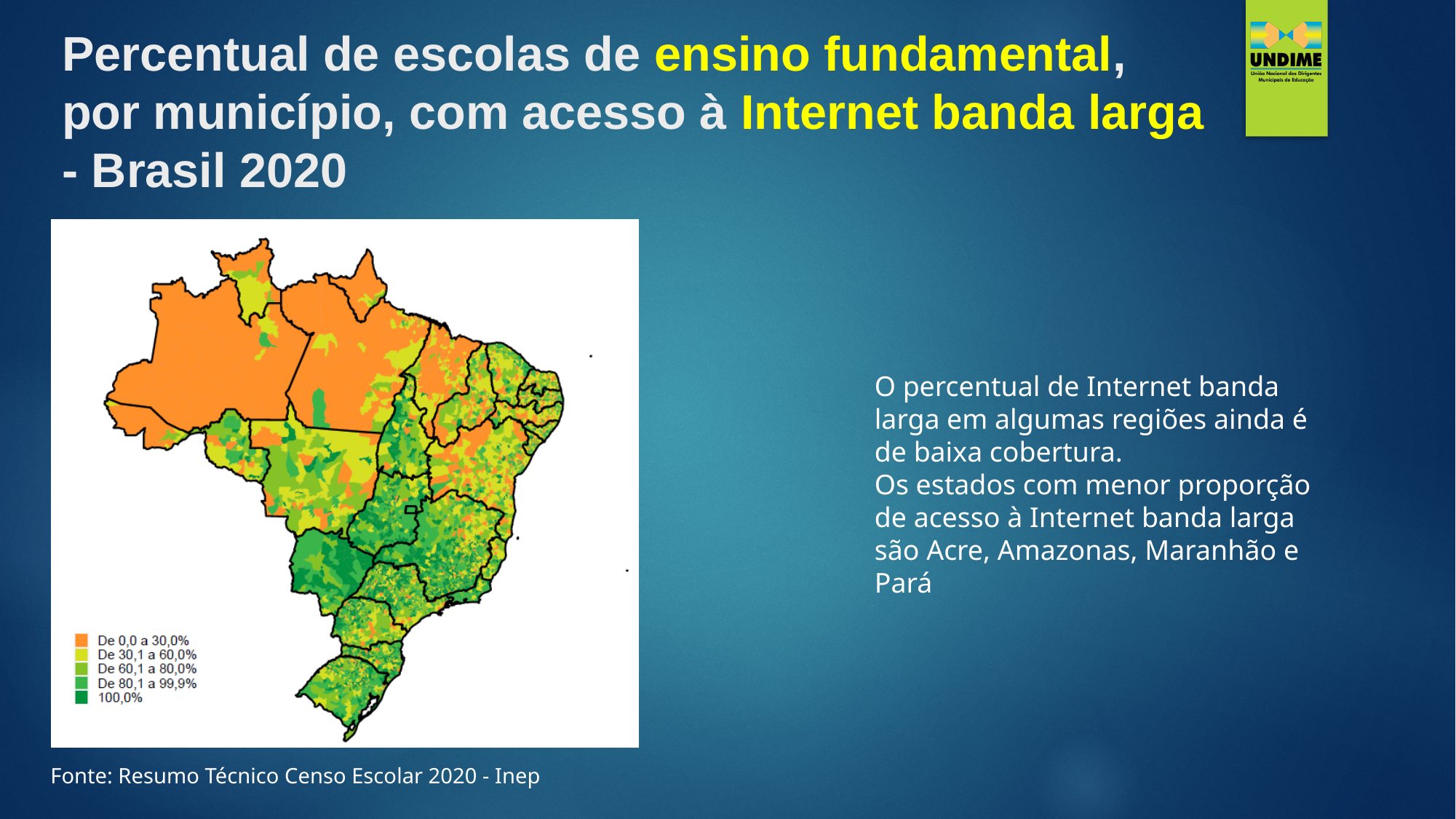
What value does the darkest green colour represent in the map legend? 100,0% How many value ranges does the map legend list? 5 What is the highest value shown in the map legend? 100,0% What value range does the orange colour represent in the map legend? De 0,0 a 30,0% Which year does the map refer to? 2020 What is the source cited for the map? Resumo Técnico Censo Escolar 2020 - Inep What kind of chart is shown on the slide? A map (choropleth map of Brazil) What is the lowest value range shown in the map legend? De 0,0 a 30,0%